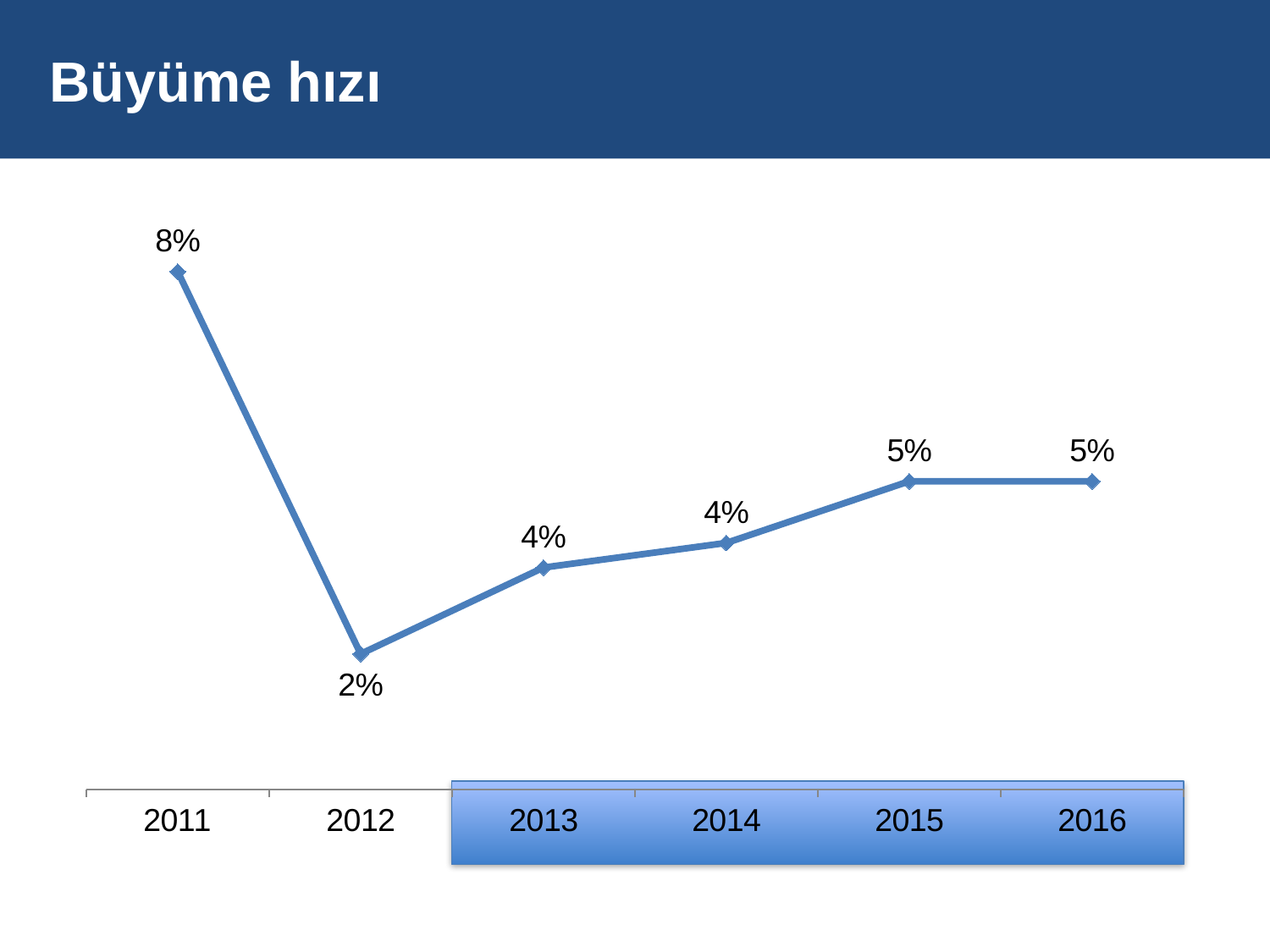
Do the values rise or fall from 2012 to 2015? rise How many years are plotted on the chart? 6 What is the growth rate value for 2011? 8% Which year has the highest growth rate? 2011 What is the growth rate value for 2014? 4% What is the growth rate value for 2012? 2% Which year has the lowest growth rate? 2012 What is the difference between the growth rate in 2011 and in 2012? 6% What kind of chart is shown on the slide? line chart Which year has a larger growth rate, 2013 or 2015? 2015 What is the difference between the growth rate in 2015 and in 2013? 1% What is the growth rate value for 2016? 5%